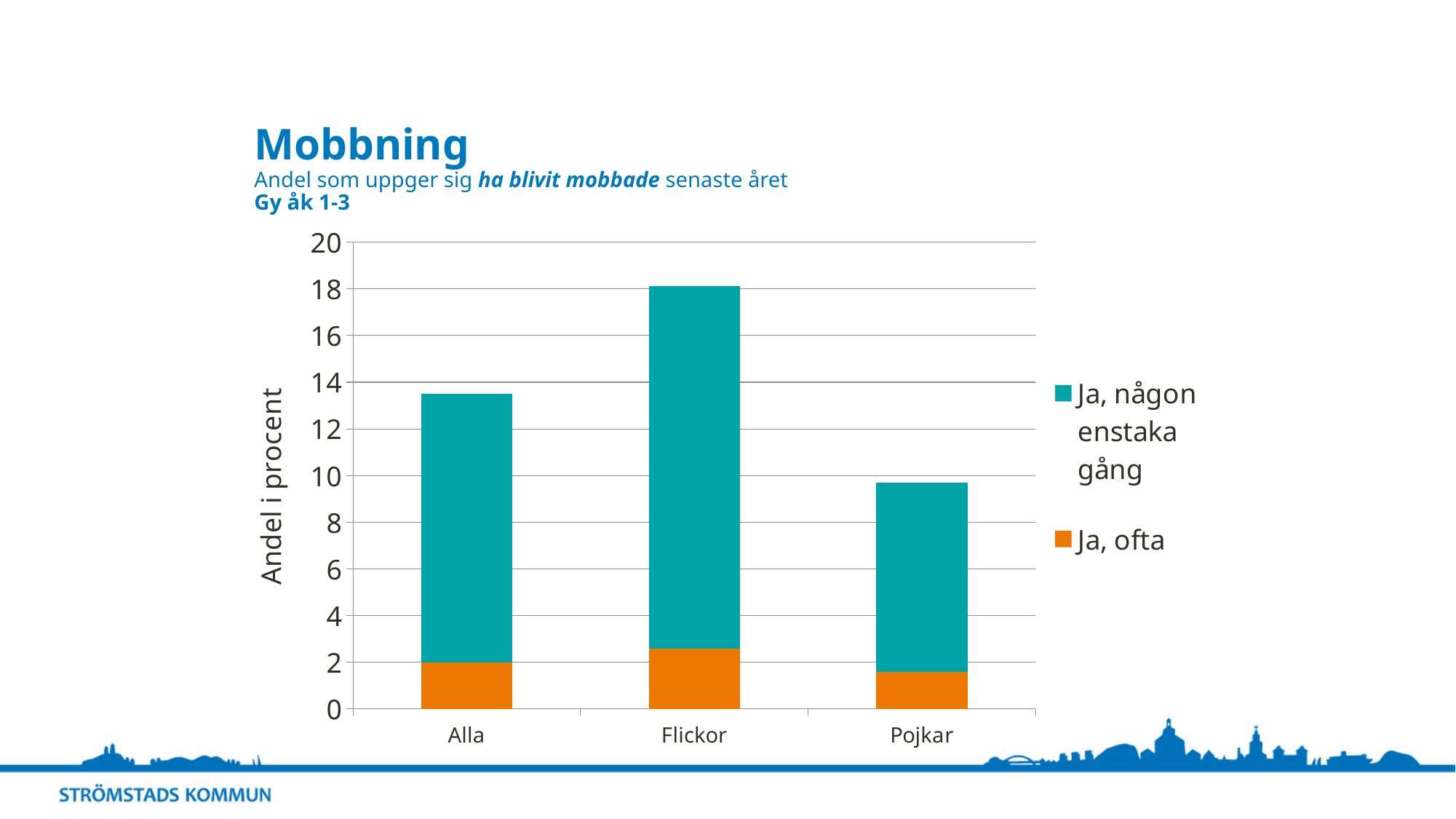
Is the total bar for Alla greater or less than 12? greater Is the total bar for Flickor greater or less than 16? greater What kind of chart is shown on the slide? Stacked bar chart Which category has the highest total bar? Flickor Which category has the lowest total bar? Pojkar Is the total bar for Pojkar greater or less than 12? less Which has the larger total bar, Alla or Pojkar? Alla How many series does the legend list? 2 How many categories are shown on the x axis? 3 Which has the larger 'Ja, ofta' segment, Flickor or Pojkar? Flickor What is the title of the y axis? Andel i procent